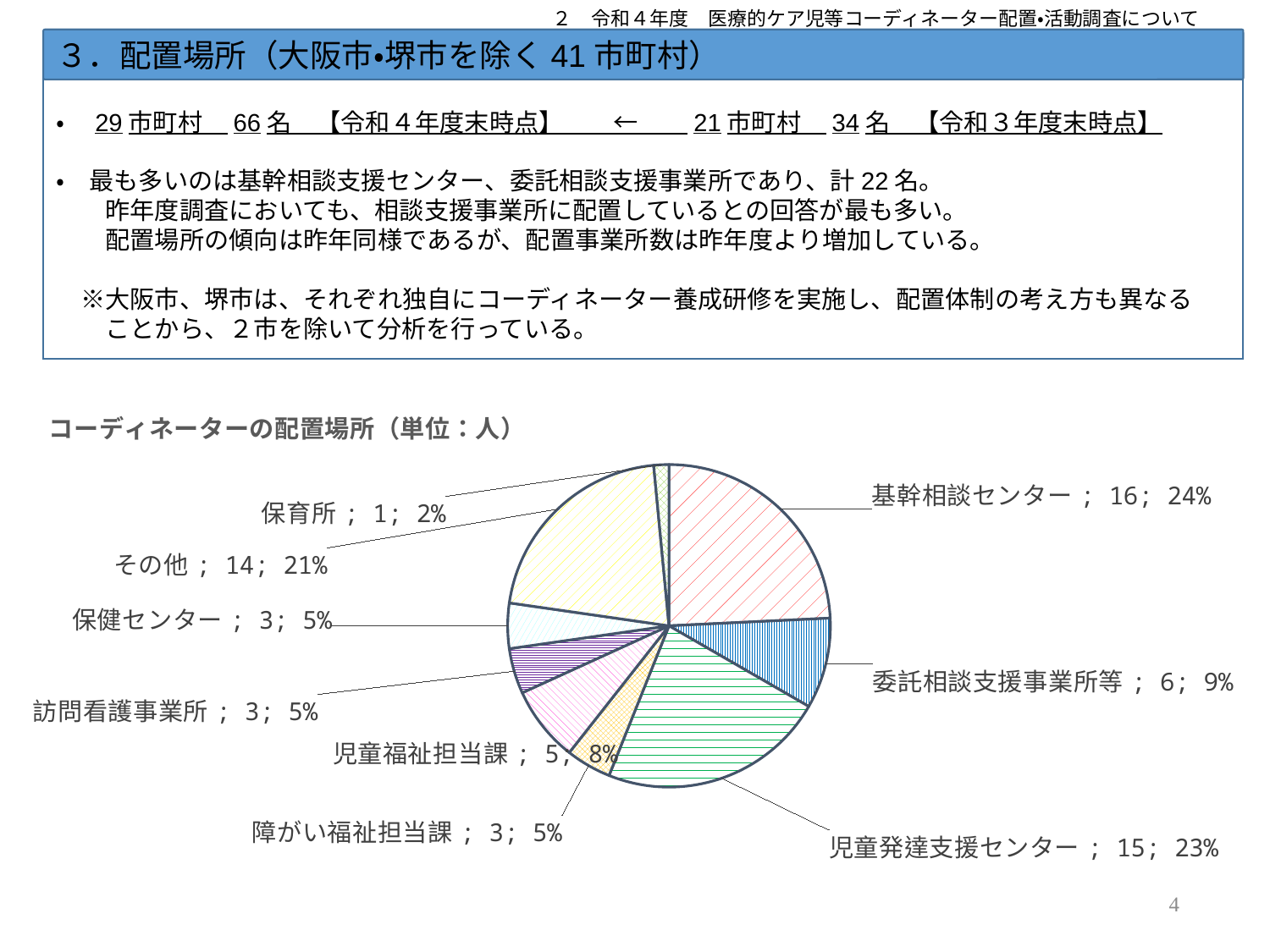
What is the value for 訪問看護事業所 in the pie chart? 3 What kind of chart is shown on the slide? pie chart What is the title of the pie chart? コーディネーターの配置場所（単位：人） What is the value for 基幹相談センター in the pie chart? 16 Which category has the smallest slice in the pie chart? 保育所 What percentage share does 委託相談支援事業所等 have in the pie chart? 9% What is the value for その他 in the pie chart? 14 What is the difference between the values for 基幹相談センター and 委託相談支援事業所等? 10 Which category has the largest slice in the pie chart? 基幹相談センター What percentage share does 児童発達支援センター have in the pie chart? 23% How many categories are shown in the pie chart? 9 Which is larger, the value for 児童福祉担当課 or the value for 障がい福祉担当課? 児童福祉担当課